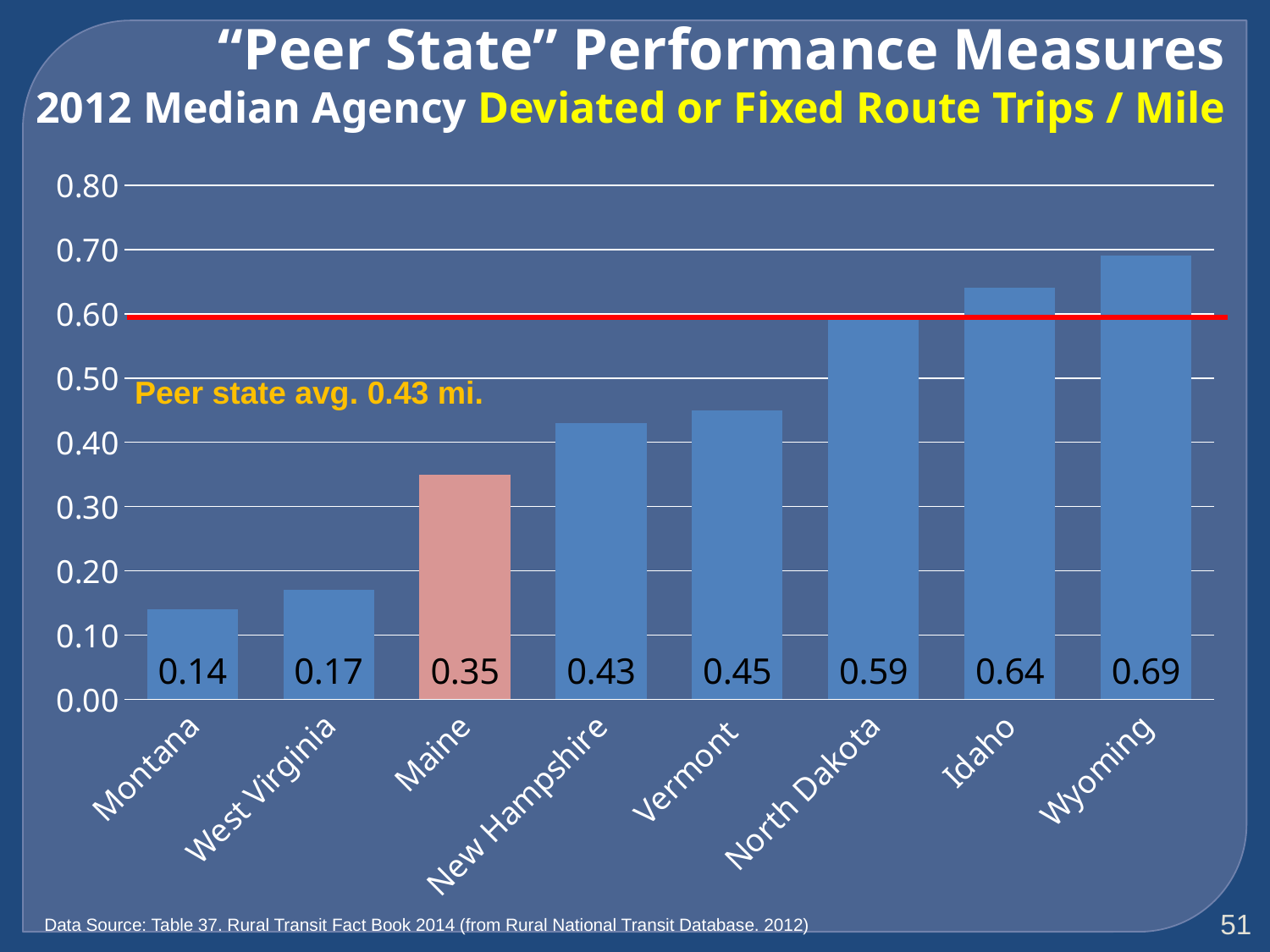
Which state has the lowest value? Montana Which state has the highest value? Wyoming Is the value for Idaho greater or less than 0.60? greater What peer state average is noted on the chart? 0.43 mi. What kind of chart is shown on the slide? bar chart What is the value for Montana? 0.14 What is the difference between the values for Idaho and Vermont? 0.19 What is the value for Maine? 0.35 Which is larger, the value for West Virginia or the value for New Hampshire? New Hampshire What is the value for North Dakota? 0.59 What is the difference between the values for Wyoming and Maine? 0.34 How many states are shown in the chart? 8